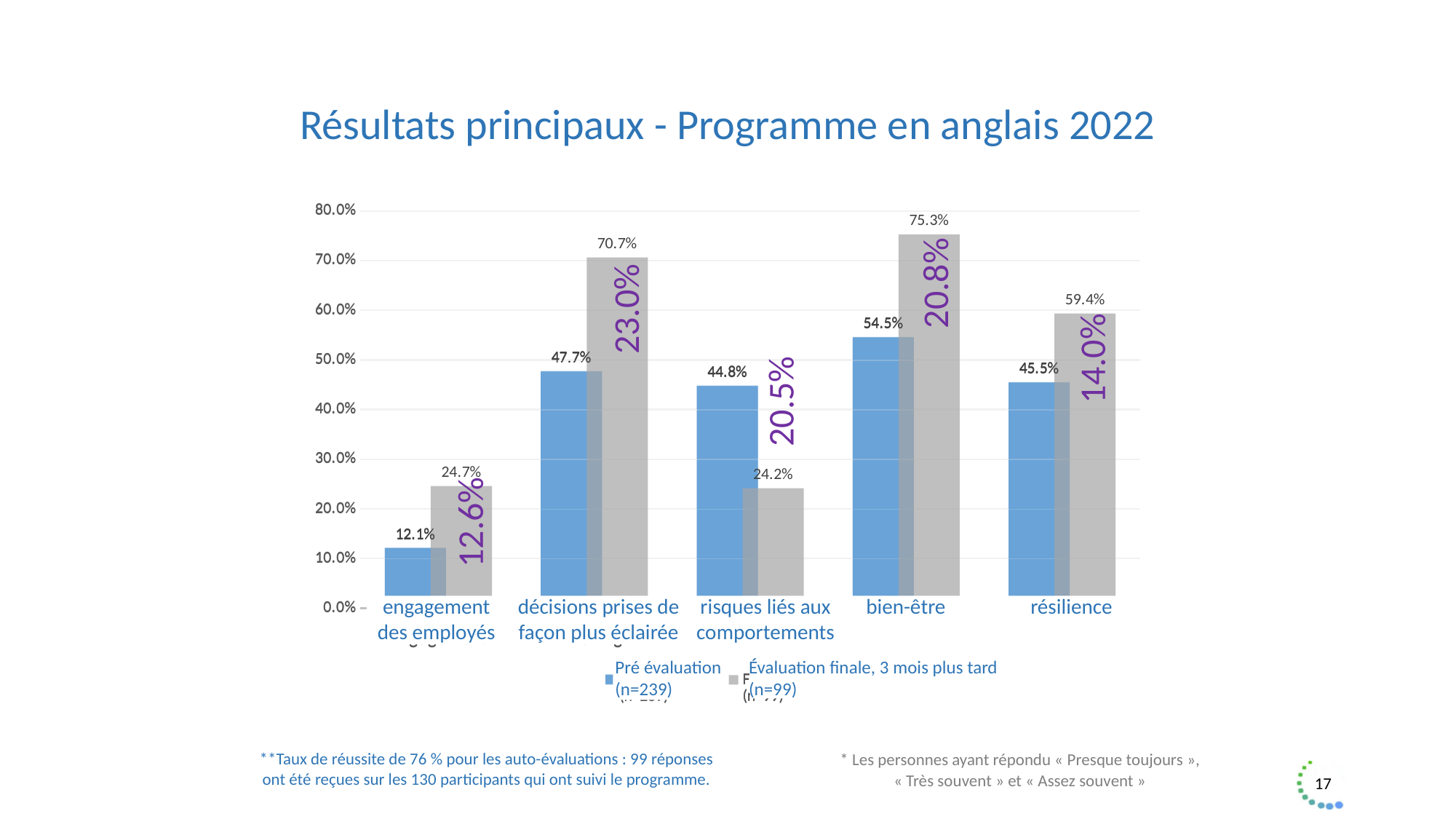
Which category has the highest Évaluation finale value? bien-être What is the Évaluation finale value for résilience? 59.4% What is the title of the slide? Résultats principaux - Programme en anglais 2022 How many categories are shown on the x axis? 5 How many series does the legend list? 2 What is the Pré évaluation value for engagement des employés? 12.1% What is the Évaluation finale value for bien-être? 75.3% Which is larger for risques liés aux comportements: the Pré évaluation value or the Évaluation finale value? Pré évaluation What is the Pré évaluation value for risques liés aux comportements? 44.8% What type of chart is shown on the slide? bar chart What is the difference between the Évaluation finale and Pré évaluation values for décisions prises de façon plus éclairée? 23.0% Which category has the lowest Pré évaluation value? engagement des employés